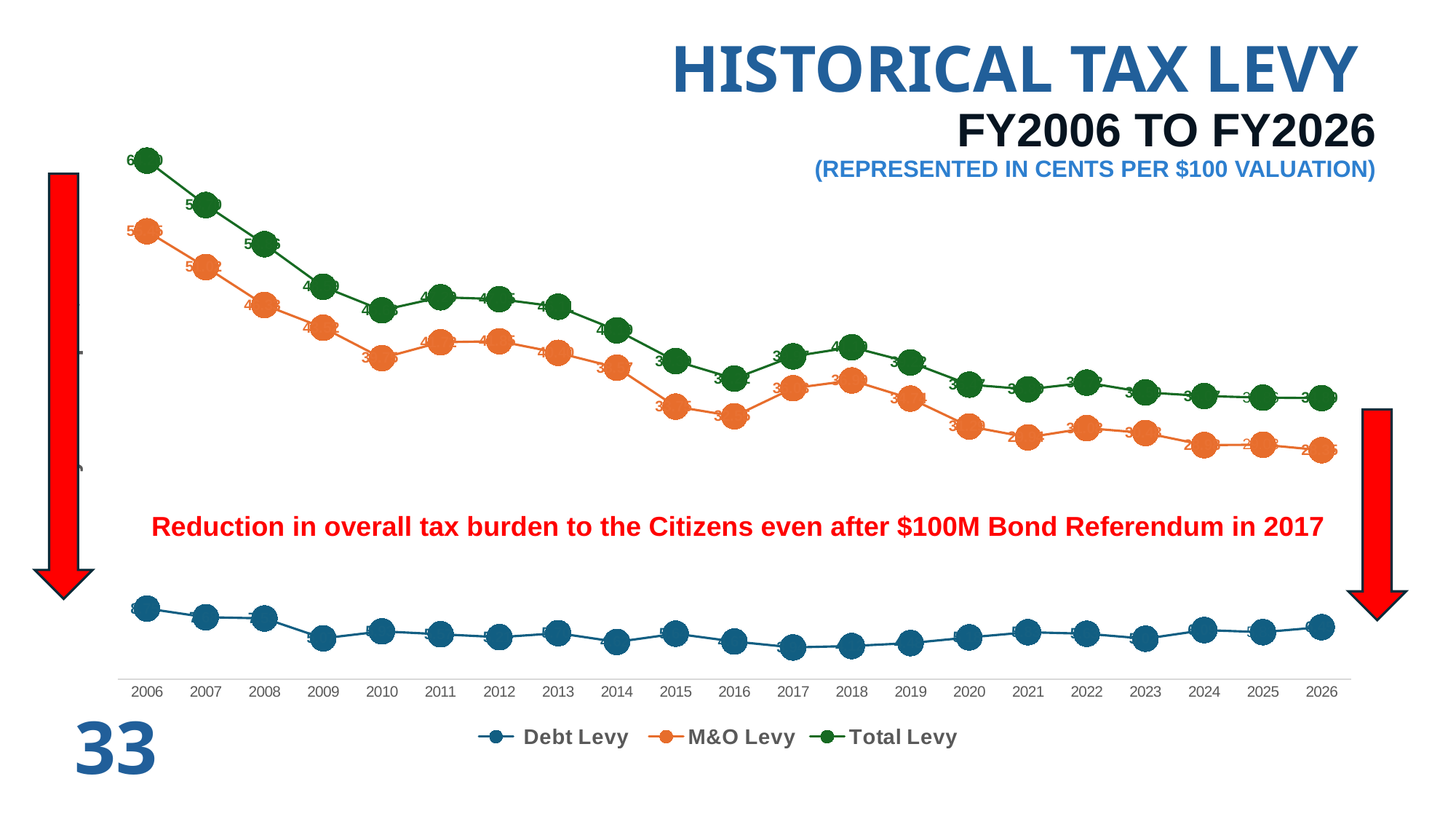
How many series does the legend list? 3 Which is larger: the M&O Levy in 2006 or the M&O Levy in 2016? M&O Levy in 2006 What kind of chart is shown on the slide? Line chart Which year has the highest Total Levy? 2006 In 2006, which is larger: the Total Levy or the Debt Levy? Total Levy Does the M&O Levy generally rise or fall from 2006 to 2026? Fall Which year has the highest Debt Levy? 2006 How many years are plotted along the x axis? 21 What is the title of the chart? Historical Tax Levy FY2006 to FY2026 Which year has the highest M&O Levy? 2006 Does the Total Levy generally rise or fall from 2006 to 2026? Fall What colour is the Total Levy line? Green